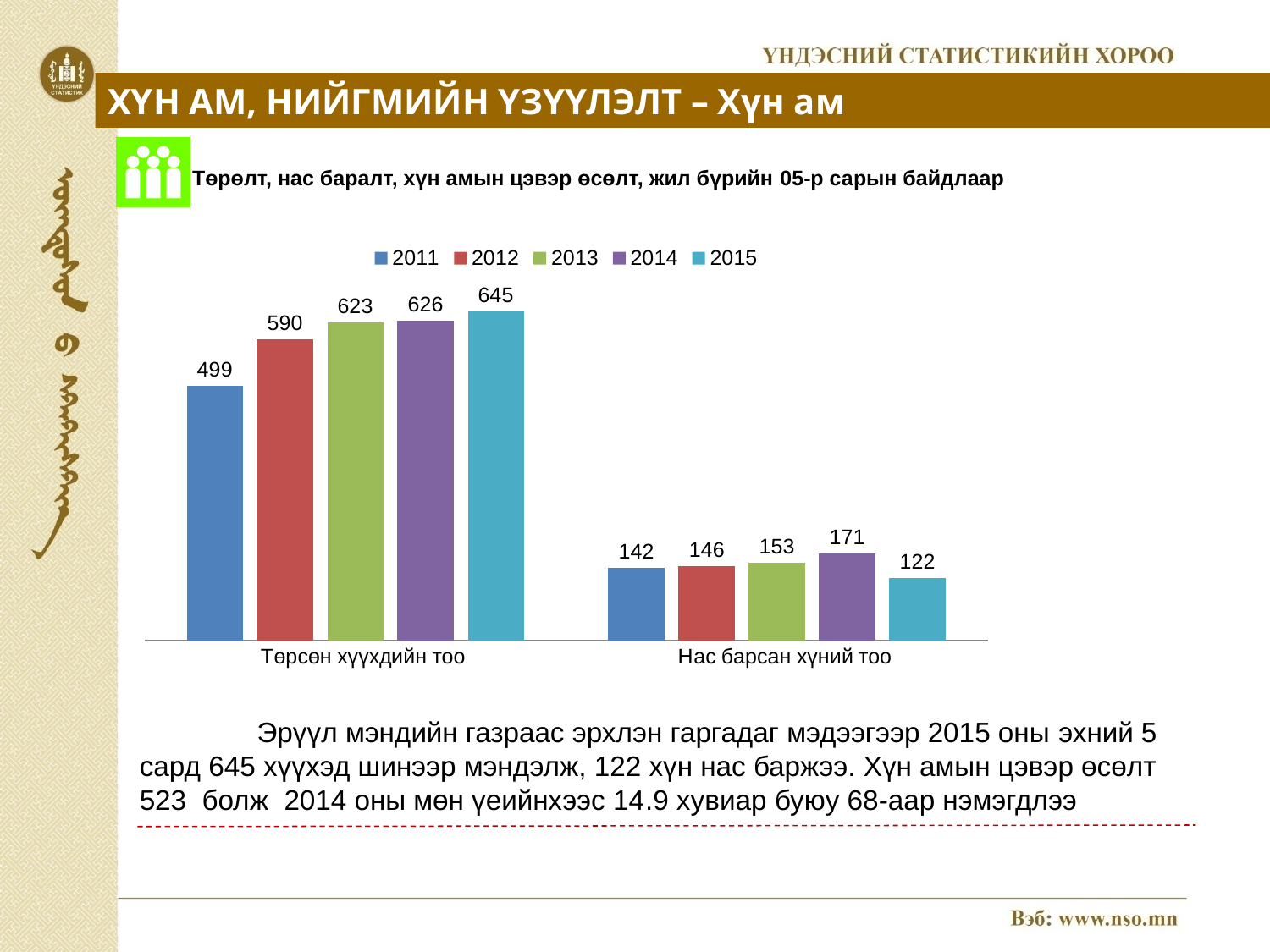
Which year has the highest value in the "Төрсөн хүүхдийн тоо" category? 2015 What is the value for 2015 in the "Төрсөн хүүхдийн тоо" category? 645 What is the difference between the 2015 and 2011 values in the "Төрсөн хүүхдийн тоо" category? 146 What is the difference between the 2014 and 2015 values in the "Нас барсан хүний тоо" category? 49 What is the value for 2011 in the "Нас барсан хүний тоо" category? 142 How many categories are shown on the x axis? 2 What kind of chart is shown on the slide? Bar chart Do the values in the "Төрсөн хүүхдийн тоо" category rise or fall from 2011 to 2015? Rise What is the value for 2014 in the "Нас барсан хүний тоо" category? 171 How many series does the legend list? 5 Which year has the lowest value in the "Нас барсан хүний тоо" category? 2015 Which is larger in the "Нас барсан хүний тоо" category: the value for 2013 or the value for 2014? 2014